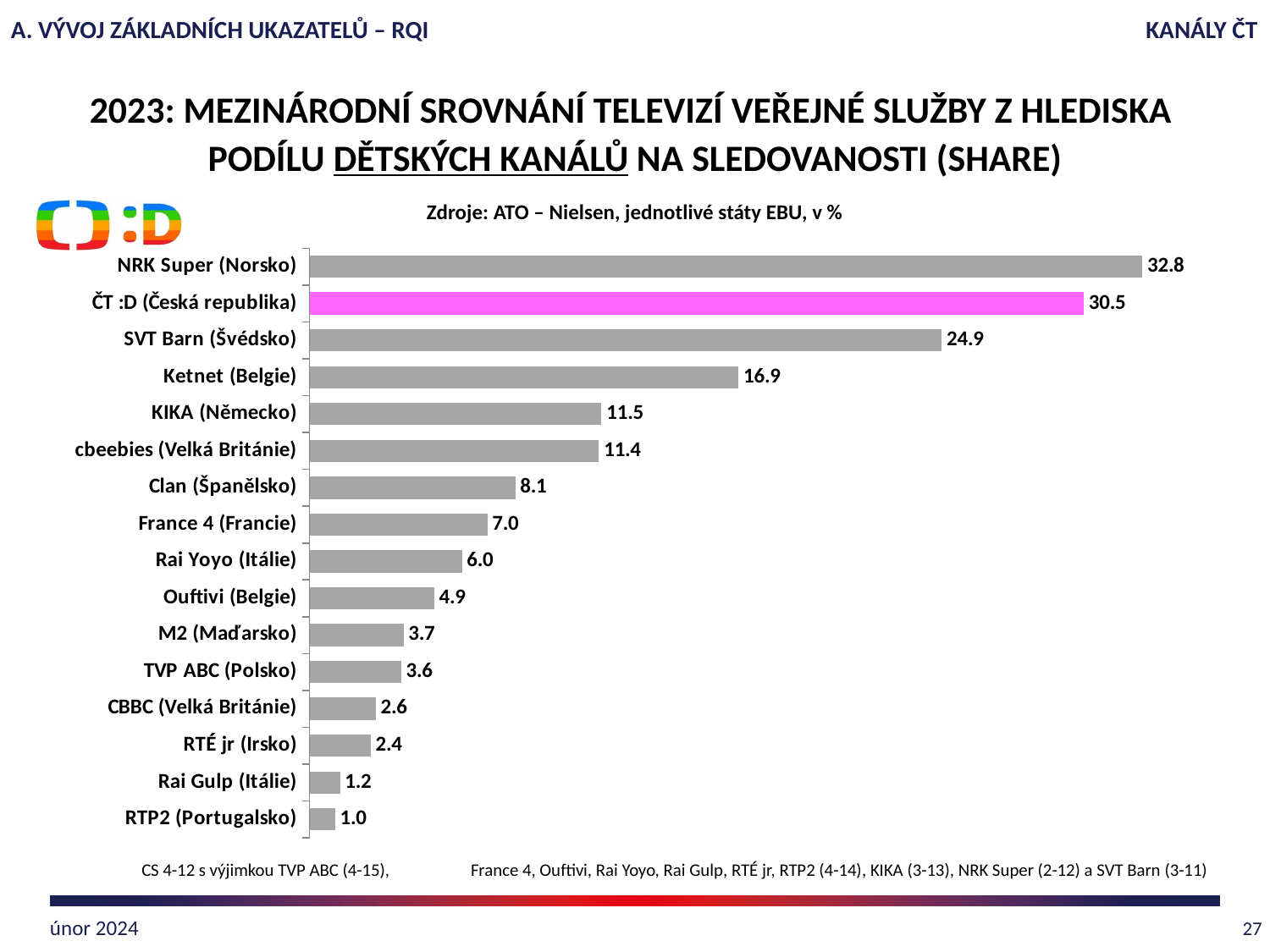
What is the value for Ketnet (Belgie)? 16.9 How many channels are shown in the chart? 16 Which bar is highlighted in a different colour (pink) from the others? ČT :D (Česká republika) What kind of chart is shown on the slide? Bar chart What is the difference between the values for SVT Barn (Švédsko) and Ketnet (Belgie)? 8.0 Which channel has the highest value? NRK Super (Norsko) What is the value for ČT :D (Česká republika)? 30.5 What is the value for Rai Yoyo (Itálie)? 6.0 Which is larger, the value for Clan (Španělsko) or the value for Ouftivi (Belgie)? Clan (Španělsko) Which is larger, the value for KIKA (Německo) or the value for cbeebies (Velká Británie)? KIKA (Německo) What is the difference between the values for NRK Super (Norsko) and ČT :D (Česká republika)? 2.3 Which channel has the lowest value? RTP2 (Portugalsko)